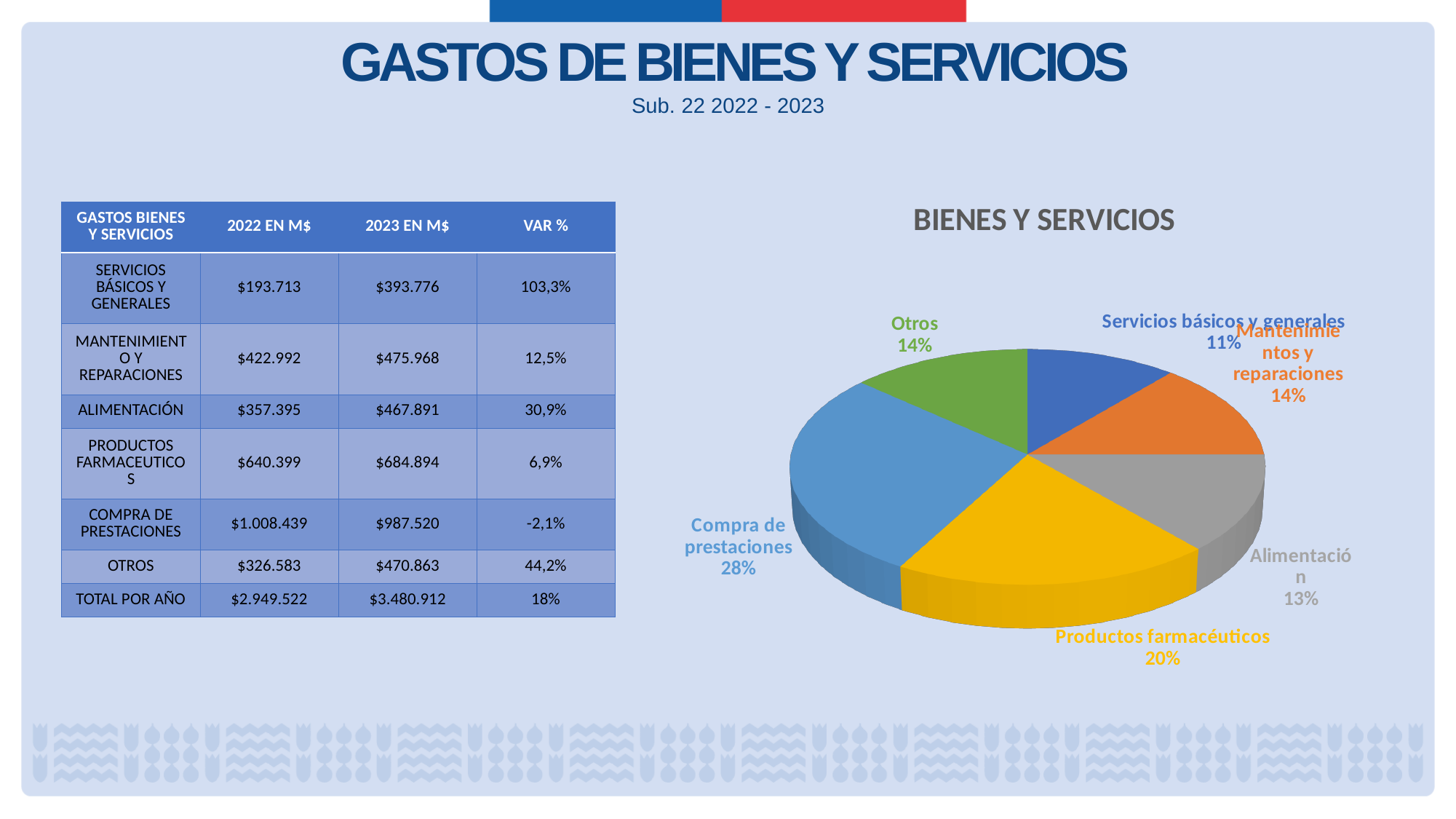
Which slice of the pie chart is the largest? Compra de prestaciones Which slice of the pie chart is the smallest? Servicios básicos y generales What is the title of the pie chart? BIENES Y SERVICIOS What share of the pie chart is Alimentación? 13% In the pie chart, which is larger: Alimentación or Mantenimientos y reparaciones? Mantenimientos y reparaciones In the pie chart, what is the difference in percentage points between Compra de prestaciones and Productos farmacéuticos? 8 percentage points What share of the pie chart is Servicios básicos y generales? 11% How many slices does the pie chart have? 6 What share of the pie chart is Compra de prestaciones? 28% What kind of chart is shown on the slide? Pie chart